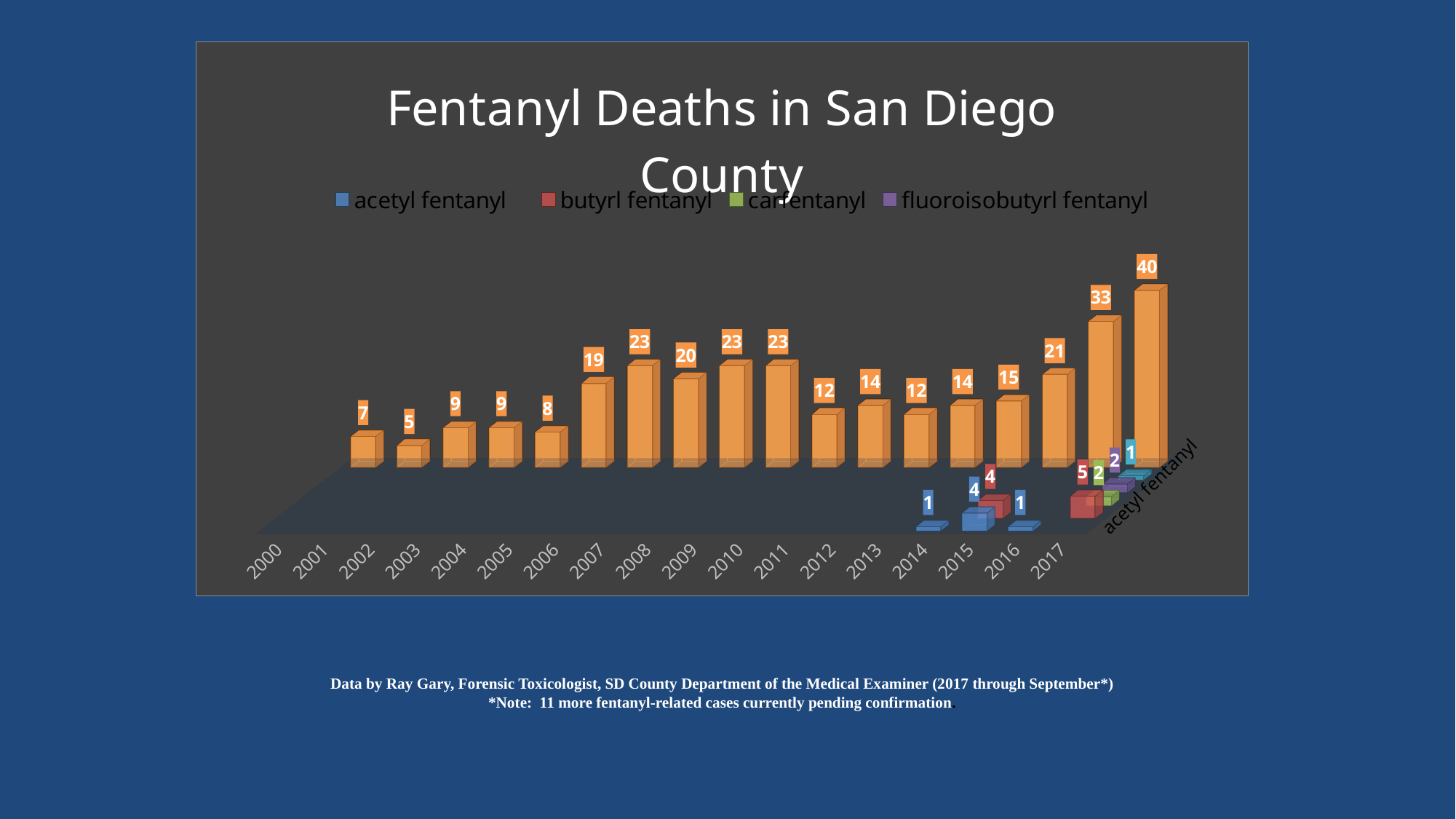
Do the orange bars rise or fall over the last three years (2015 to 2017)? rise What is the highest value labelled on the orange bars? 40 What is the value of the last (rightmost) orange bar, for 2017? 40 What kind of chart is shown on the slide? bar chart Which legend entry is shown in blue? acetyl fentanyl What is the value of the acetyl fentanyl bar for 2015? 4 What is the lowest value labelled on the orange bars? 5 Which is larger, the orange bar labelled 21 or the orange bar labelled 33? 33 How many years are shown along the x axis? 18 What is the title of the chart? Fentanyl Deaths in San Diego County What is the difference between the two tallest orange bars, labelled 40 and 33? 7 How many series does the legend list? 4